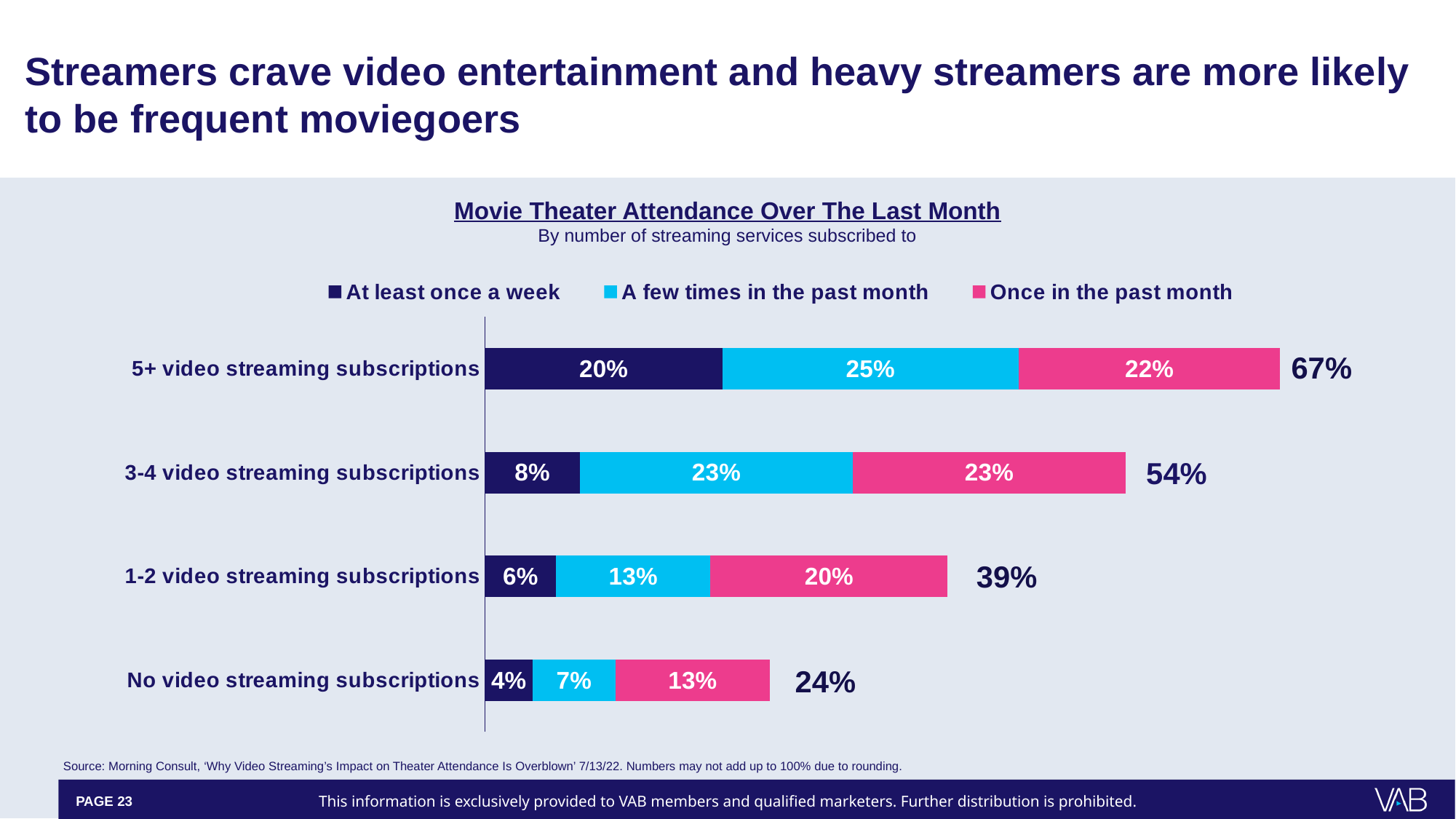
How many series does the legend list? 3 Which category has the highest total movie theater attendance? 5+ video streaming subscriptions What percentage of people with 5+ video streaming subscriptions attended a movie theater at least once a week? 20% What is the 'A few times in the past month' value for 3-4 video streaming subscriptions? 23% What kind of chart is shown on the slide? Stacked bar chart What is the difference between the totals for 5+ video streaming subscriptions and No video streaming subscriptions? 43% Which is larger: the 'At least once a week' value for 3-4 video streaming subscriptions or for 1-2 video streaming subscriptions? 3-4 video streaming subscriptions How many categories are shown on the chart? 4 What is the 'Once in the past month' value for No video streaming subscriptions? 13% What is the title of the chart? Movie Theater Attendance Over The Last Month Which category has the lowest 'At least once a week' value? No video streaming subscriptions What is the total shown for the 1-2 video streaming subscriptions bar? 39%